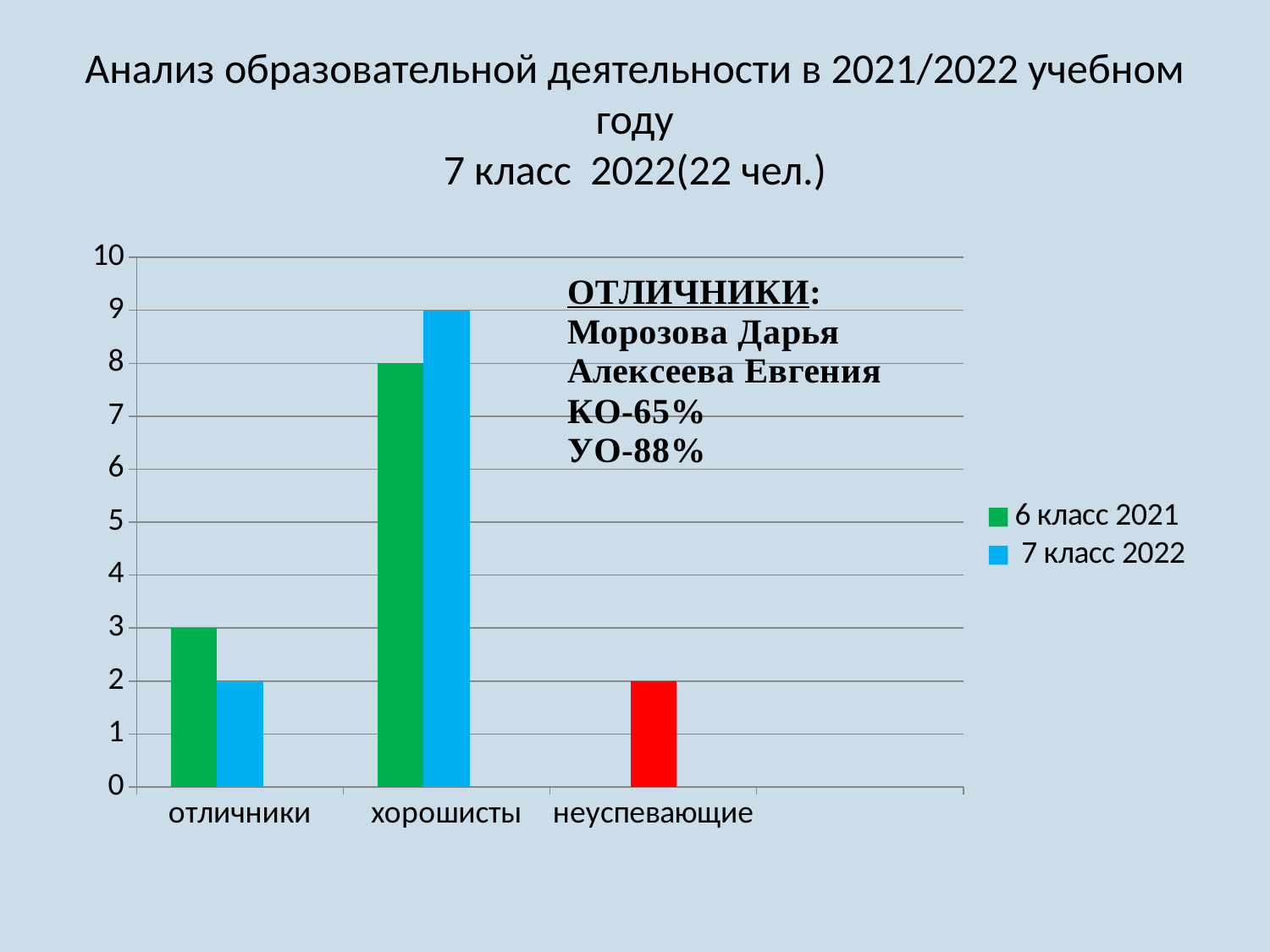
For отличники, which series has the larger value, 6 класс 2021 or 7 класс 2022? 6 класс 2021 What is the difference between the 7 класс 2022 and 6 класс 2021 values for хорошисты? 1 Is the value for хорошисты in the 6 класс 2021 series greater or less than 5? greater How many categories are shown on the x axis? 3 What is the value of the red bar at неуспевающие? 2 What is the value for отличники in the 6 класс 2021 series? 3 How many series does the legend list? 2 What kind of chart is shown on the slide? bar chart What is the value for хорошисты in the 7 класс 2022 series? 9 Which category has the highest value in the 7 класс 2022 series? хорошисты What is the value for хорошисты in the 6 класс 2021 series? 8 What is the value for отличники in the 7 класс 2022 series? 2